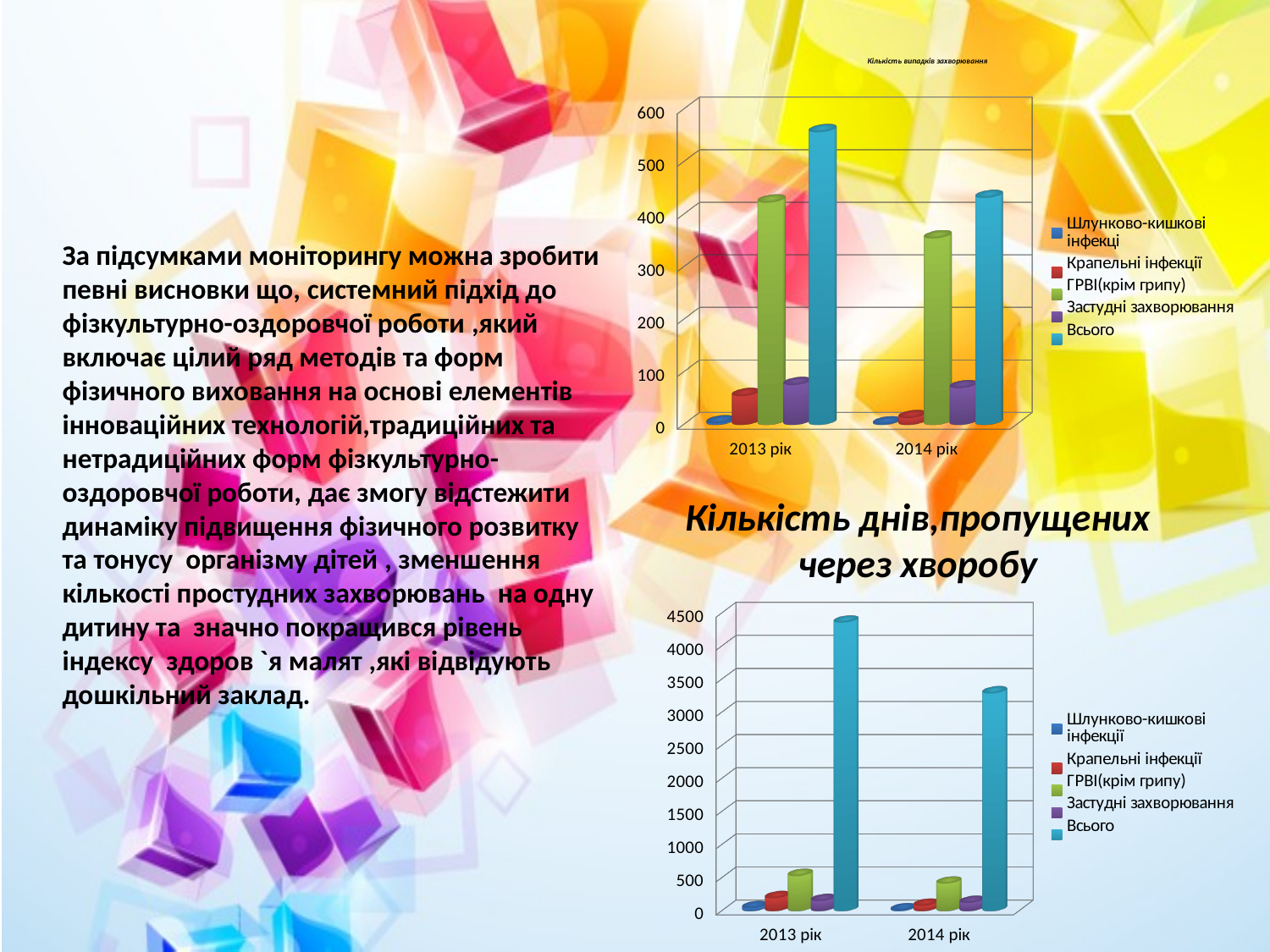
In the top chart "Кількість випадків захворювання", which series has the highest value for 2013 рік? Всього In the bottom chart "Кількість днів,пропущених через хворобу", is the value of Всього for 2013 рік greater or less than 4000? greater How many categories are shown on the x axis of the bottom chart "Кількість днів,пропущених через хворобу"? 2 In the top chart "Кількість випадків захворювання", does the value of Всього rise or fall from 2013 рік to 2014 рік? fall In the bottom chart "Кількість днів,пропущених через хворобу", which series has the lowest value for 2013 рік? Шлунково-кишкові інфекції In the bottom chart "Кількість днів,пропущених через хворобу", is the value of Всього for 2014 рік greater or less than 3500? less How many series does the legend of the top chart "Кількість випадків захворювання" list? 5 What is the title of the bottom chart on the slide? Кількість днів,пропущених через хворобу In the top chart "Кількість випадків захворювання", which is larger for 2013 рік: ГРВІ(крім грипу) or Крапельні інфекції? ГРВІ(крім грипу) In the top chart "Кількість випадків захворювання", is the value of ГРВІ(крім грипу) for 2014 рік greater or less than 400? less What kind of chart is the top chart, "Кількість випадків захворювання"? bar chart